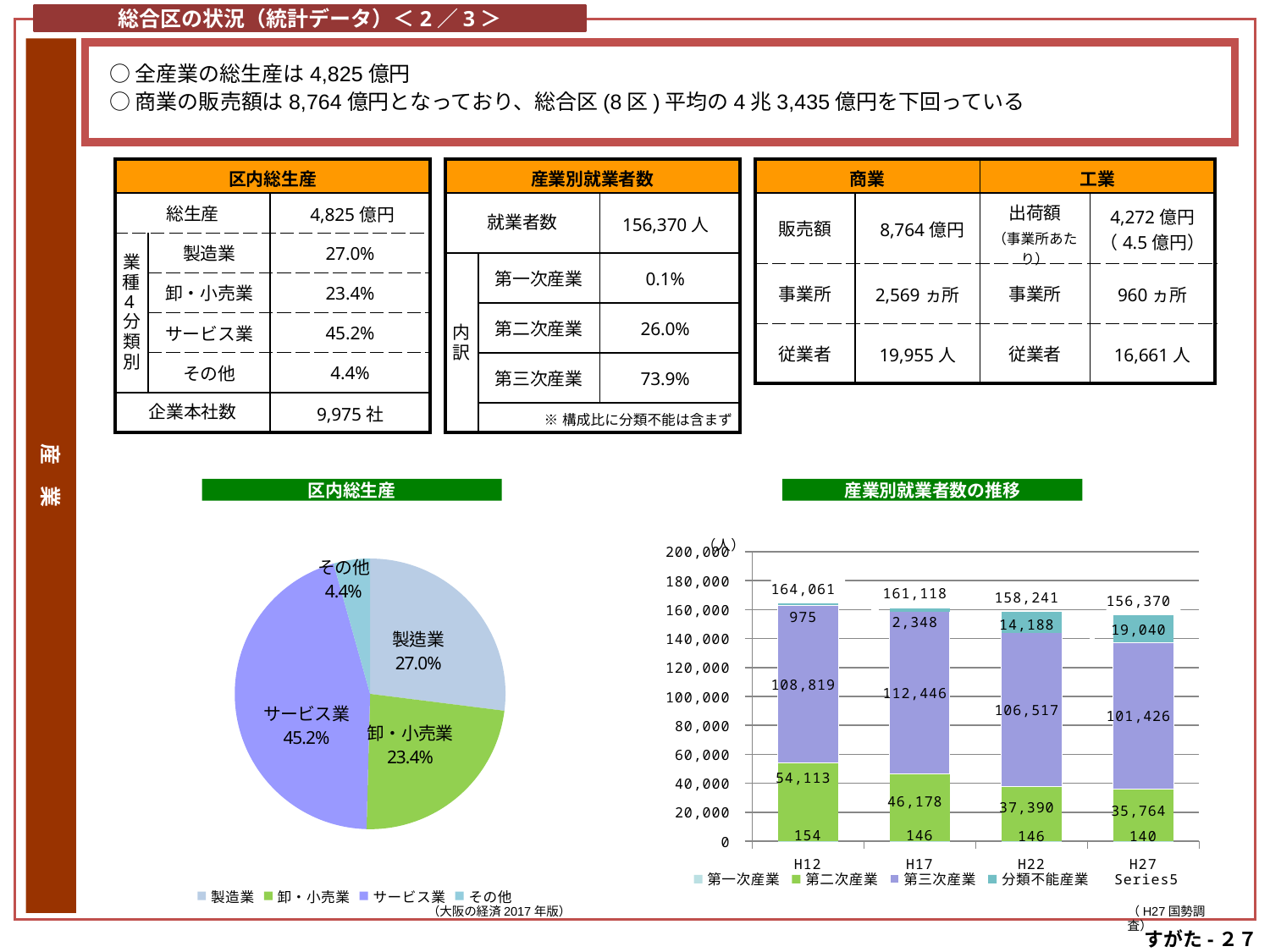
How many slices does the 区内総生産 pie chart have? 4 In the 産業別就業者数の推移 chart, do the bar totals rise or fall from H12 to H27? fall In the 区内総生産 pie chart, what share does サービス業 have? 45.2% In the 産業別就業者数の推移 chart, what is the difference between the 第二次産業 values for H12 and H27? 18,349 In the 産業別就業者数の推移 chart, which is larger: 分類不能産業 in H22 or in H27? H27 In the 区内総生産 pie chart, which slice is the smallest? その他 In the 産業別就業者数の推移 chart, what is the total of the H22 bar? 158,241 What kind of chart is the 産業別就業者数の推移 chart on the right? stacked bar chart How many year categories are shown on the x axis of the 産業別就業者数の推移 chart? 4 In the 産業別就業者数の推移 chart, what is the value for 第三次産業 in H17? 112,446 In the 区内総生産 pie chart, which slice is the largest? サービス業 What kind of chart is the 区内総生産 chart on the left? pie chart